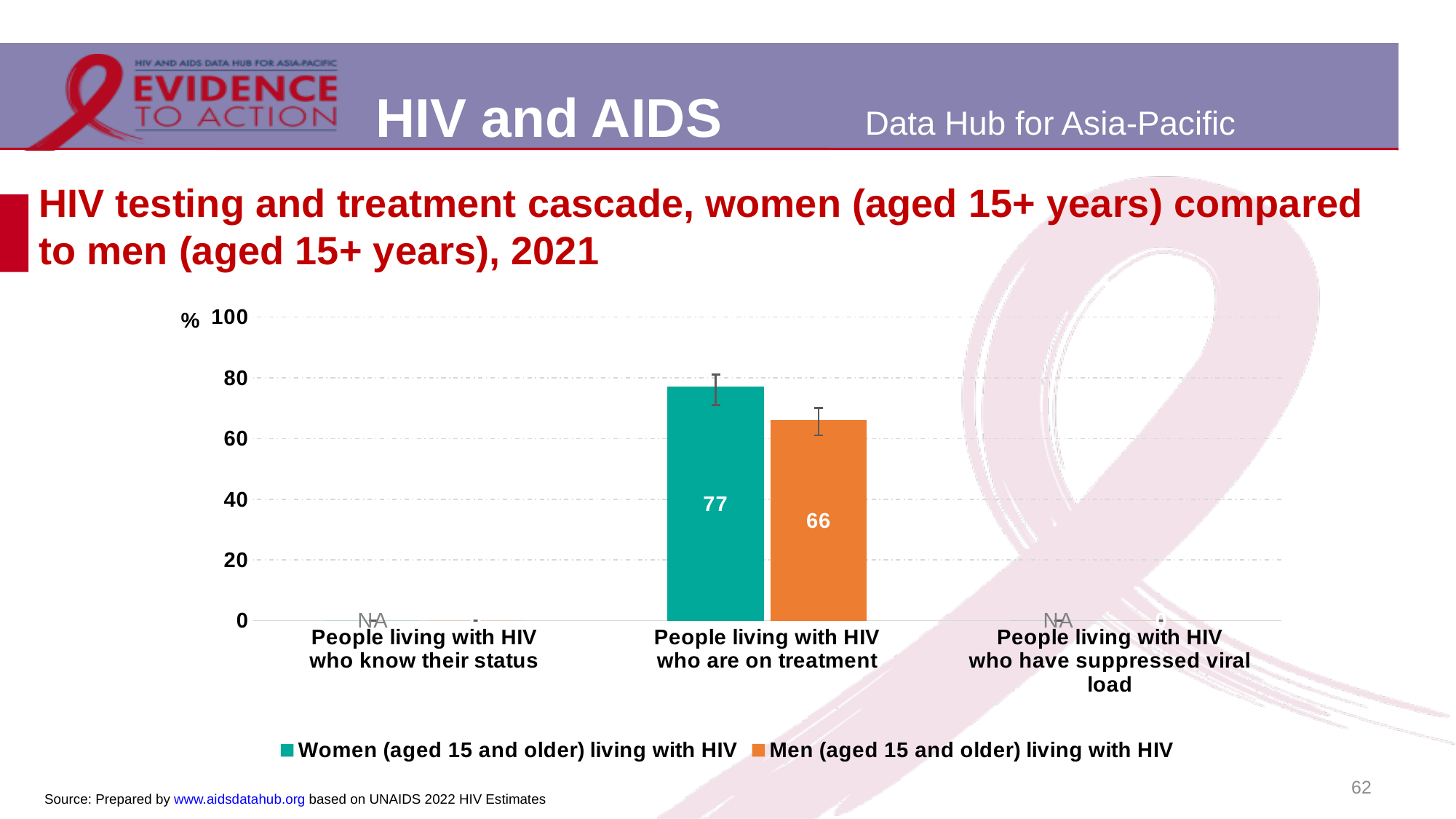
What is the difference between the women's and men's values for people living with HIV who are on treatment? 11 What is the value for women (aged 15 and older) living with HIV who are on treatment? 77 What is the unit shown on the y axis of the chart? % How many series does the legend list? 2 Is the value for women living with HIV who are on treatment greater or less than 60? greater For people living with HIV who are on treatment, which series has the larger value, women or men? Women (aged 15 and older) living with HIV Which colour represents men (aged 15 and older) living with HIV in the chart? Orange How many categories are shown on the x axis of the chart? 3 What is the value for men (aged 15 and older) living with HIV who are on treatment? 66 Is the value for men living with HIV who are on treatment greater or less than 80? less What is shown for the category 'People living with HIV who know their status'? NA What kind of chart is shown on the slide? Bar chart